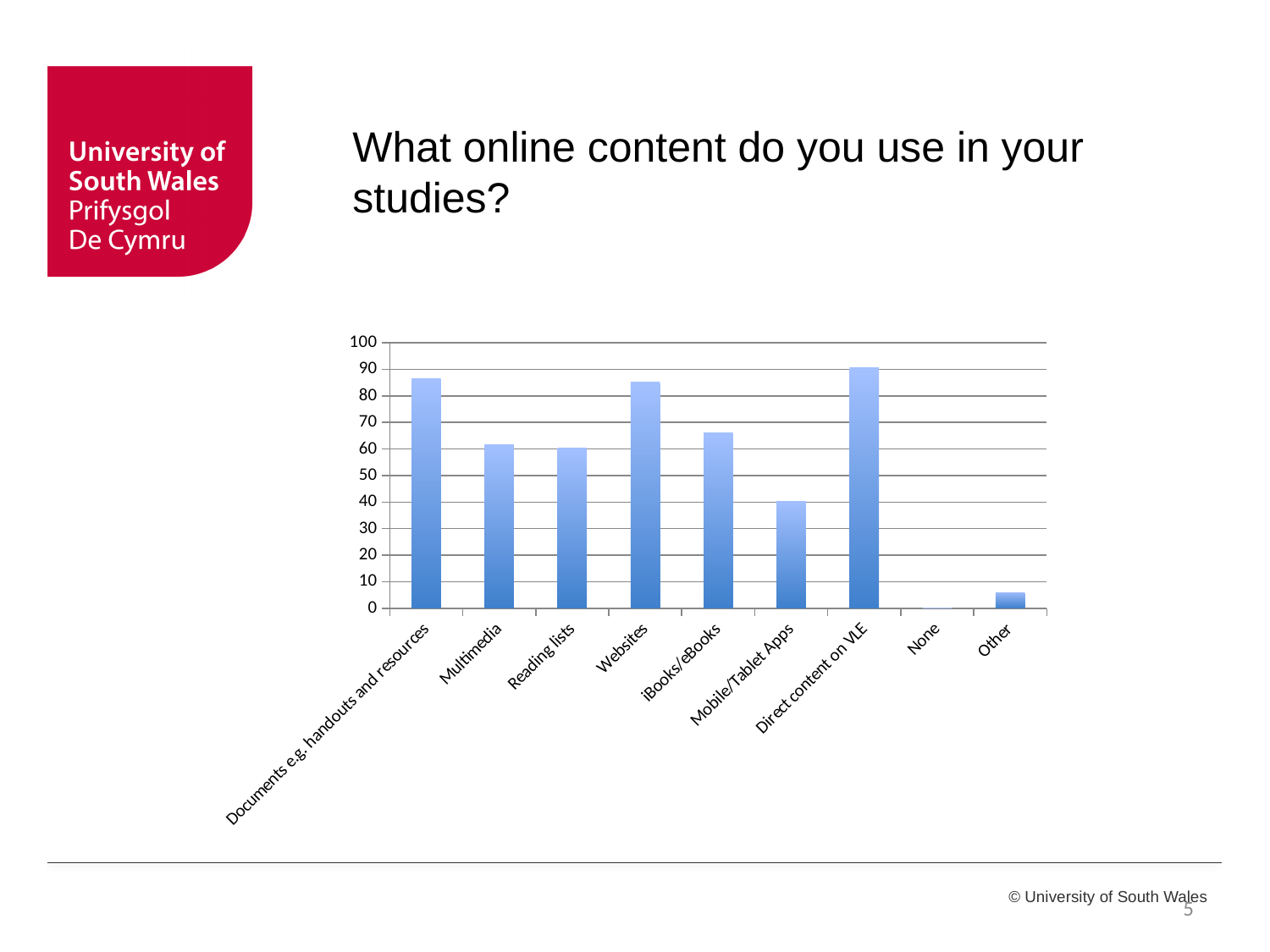
Which is larger, the value for Websites or the value for Mobile/Tablet Apps? Websites How many categories are shown on the x axis of the chart? 9 Which is larger, the value for Other or the value for None? Other Is the value for Reading lists greater or less than 70? less Which category has the highest bar in the chart? Direct content on VLE Is the value for Websites greater or less than 80? greater Is the value for Mobile/Tablet Apps greater or less than 50? less What is the title of the slide containing the chart? What online content do you use in your studies? What kind of chart is shown on the slide? bar chart Which category has the lowest bar in the chart? None